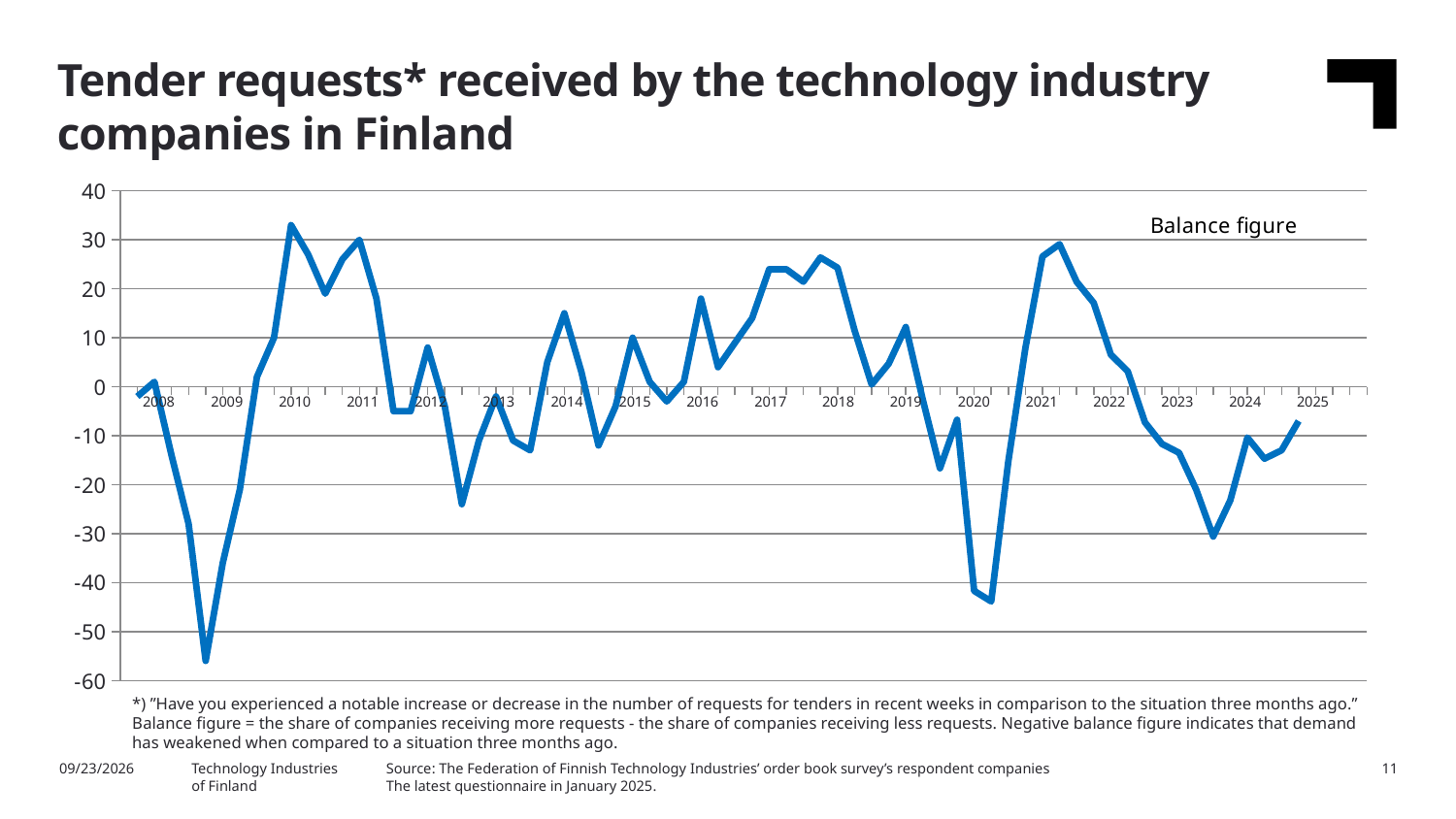
Is the peak value of the balance figure in 2010 greater or less than 30? greater How many year labels are shown on the x axis? 18 What kind of chart is shown on the slide? line chart Is the lowest value of the balance figure in 2020 greater or less than -40? less Which is lower, the trough of the balance figure in 2009 or the trough in 2020? 2009 In which year does the balance figure reach its lowest point? 2009 Does the balance figure rise or fall between its peak in 2021 and 2023? fall What is the title of the chart? Balance figure Is the last plotted value of the balance figure, in 2025, greater or less than 0? less